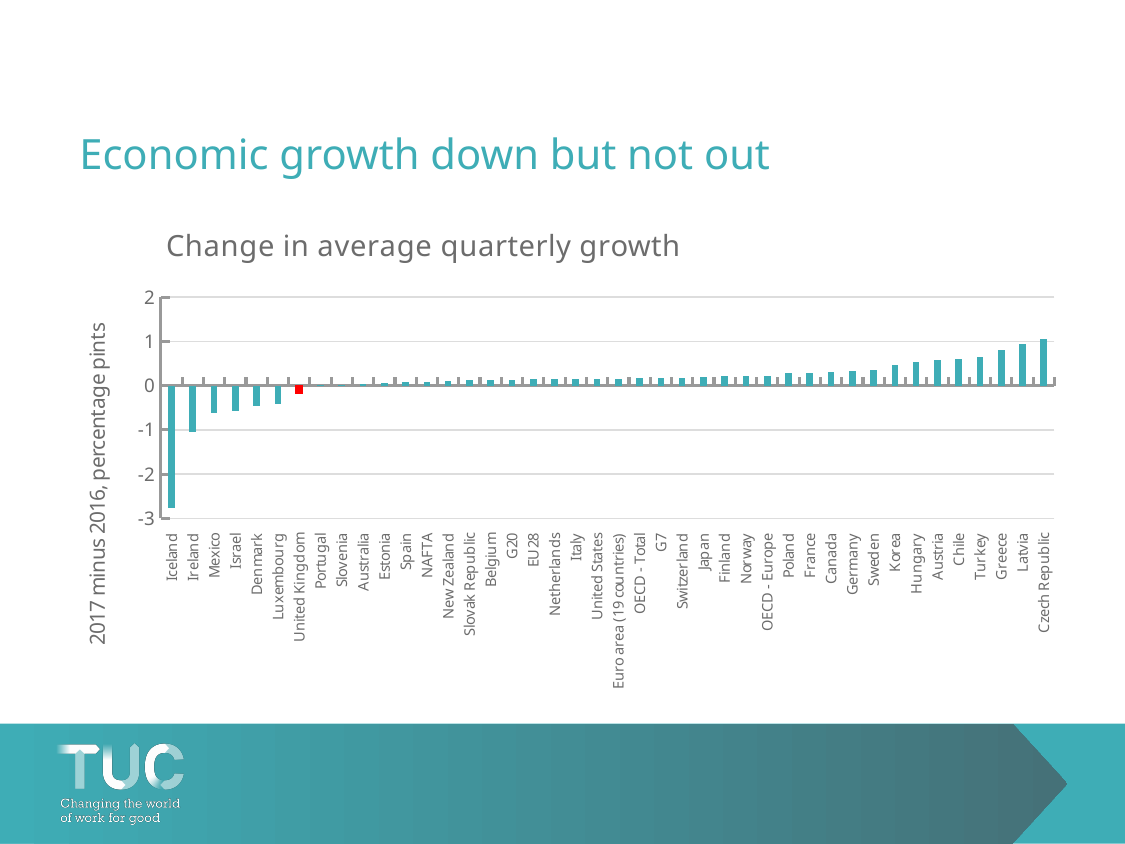
Is the value for Iceland greater or less than -2? less Which has the larger value, Ireland or Latvia? Latvia Is the value for United Kingdom greater or less than 0? less Is the value for Czech Republic greater or less than 0.5? greater Which category has the highest value in the chart? Czech Republic Which category has the lowest value in the chart? Iceland What is the label on the vertical axis of the chart? 2017 minus 2016, percentage pints What kind of chart is shown on the slide? bar chart What is the title of the chart? Change in average quarterly growth Do the values generally rise or fall moving from left to right along the x axis? rise